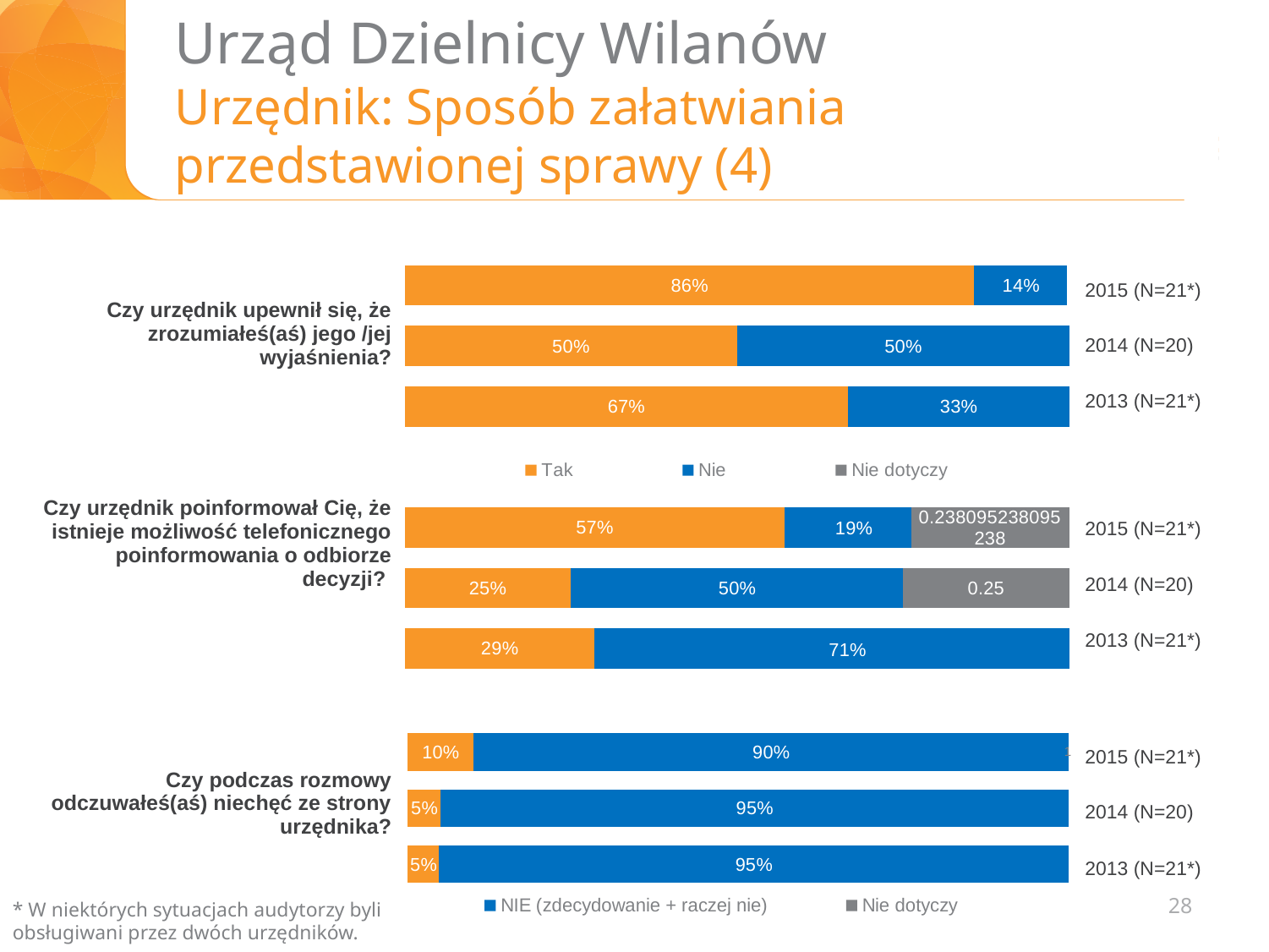
In the middle chart (Czy urzędnik poinformował Cię, że istnieje możliwość telefonicznego poinformowania o odbiorze decyzji?), which year has the lowest 'Tak' share? 2014 (N=20) In the top chart (Czy urzędnik upewnił się, że zrozumiałeś(aś) jego /jej wyjaśnienia?), which year has the highest 'Tak' share? 2015 (N=21*) In the top chart (Czy urzędnik upewnił się, że zrozumiałeś(aś) jego /jej wyjaśnienia?), what is the 'Tak' value for 2015 (N=21*)? 86% How many series does the legend of the top chart list? 3 In the bottom chart (Czy podczas rozmowy odczuwałeś(aś) niechęć ze strony urzędnika?), what is the blue 'NIE' value for 2015 (N=21*)? 90% In the bottom chart (Czy podczas rozmowy odczuwałeś(aś) niechęć ze strony urzędnika?), is the orange value for 2015 (N=21*) larger or smaller than the orange value for 2014 (N=20)? larger In the middle chart (Czy urzędnik poinformował Cię, że istnieje możliwość telefonicznego poinformowania o odbiorze decyzji?), what is the 'Nie' value for 2013 (N=21*)? 71% In the middle chart (Czy urzędnik poinformował Cię, że istnieje możliwość telefonicznego poinformowania o odbiorze decyzji?), what label is shown on the 'Nie dotyczy' segment for 2014 (N=20)? 0.25 What type of chart is used on this slide? Stacked bar chart In the top chart (Czy urzędnik upewnił się, że zrozumiałeś(aś) jego /jej wyjaśnienia?), what is the 'Nie' value for 2013 (N=21*)? 33% In the middle chart (Czy urzędnik poinformował Cię, że istnieje możliwość telefonicznego poinformowania o odbiorze decyzji?), what is the 'Tak' value for 2015 (N=21*)? 57% In the top chart (Czy urzędnik upewnił się, że zrozumiałeś(aś) jego /jej wyjaśnienia?), what is the difference between the 'Tak' and 'Nie' values for 2015 (N=21*)? 72 percentage points